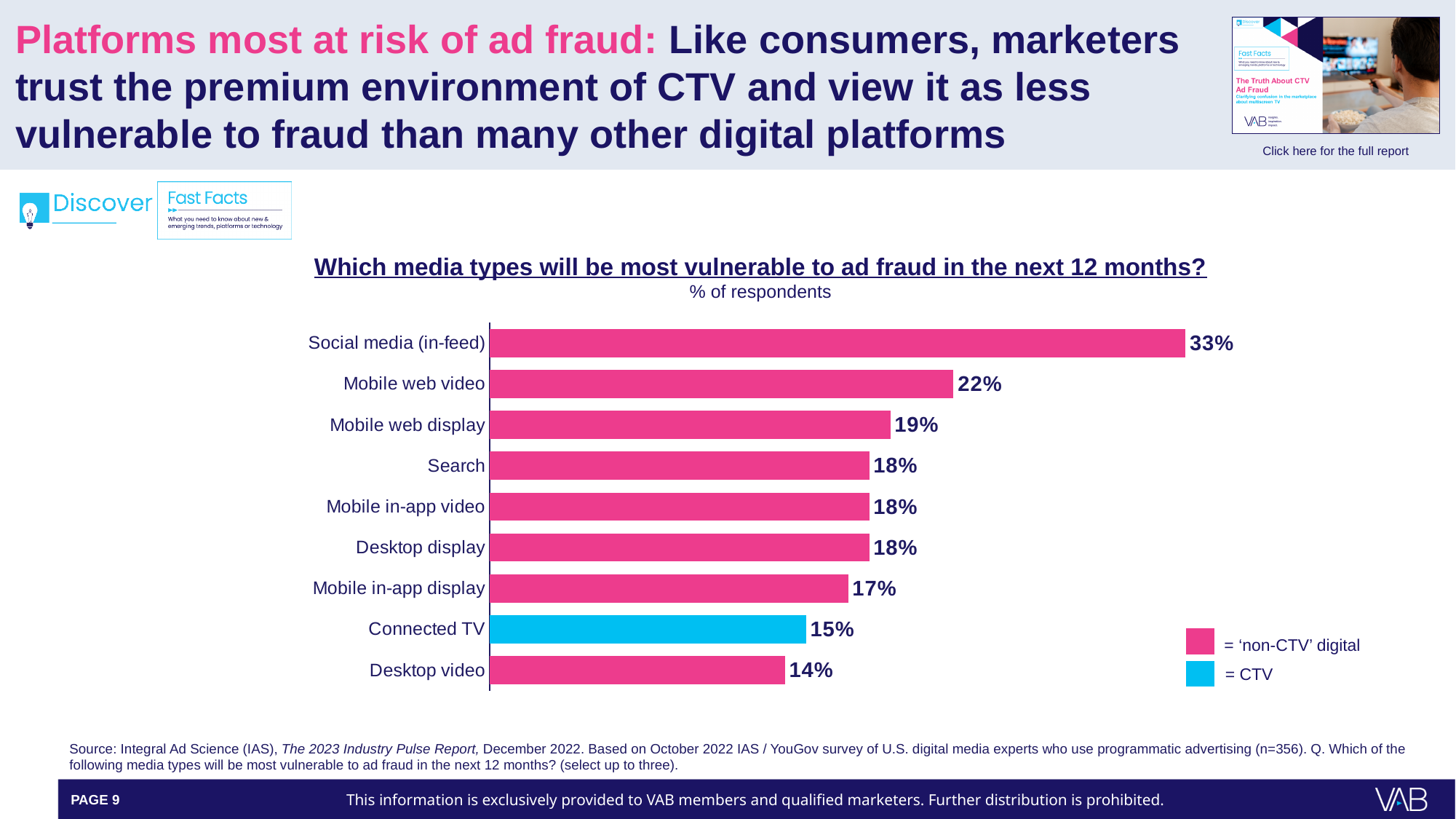
How many media types are shown in the chart? 9 What is the difference in percentage points between Social media (in-feed) and Connected TV? 18 What kind of chart is shown on the slide? Bar chart What is the value shown for Mobile web video? 22% Which media type has the highest percentage of respondents? Social media (in-feed) Which has a higher value, Mobile in-app display or Connected TV? Mobile in-app display Which media type has the lowest percentage of respondents? Desktop video What is the difference in percentage points between Mobile web video and Mobile web display? 3 What percentage of respondents selected Social media (in-feed) as most vulnerable to ad fraud? 33% What is the value shown for Connected TV? 15% How many categories does the legend list? 2 Which media type is shown in a different colour (light blue) from the others? Connected TV